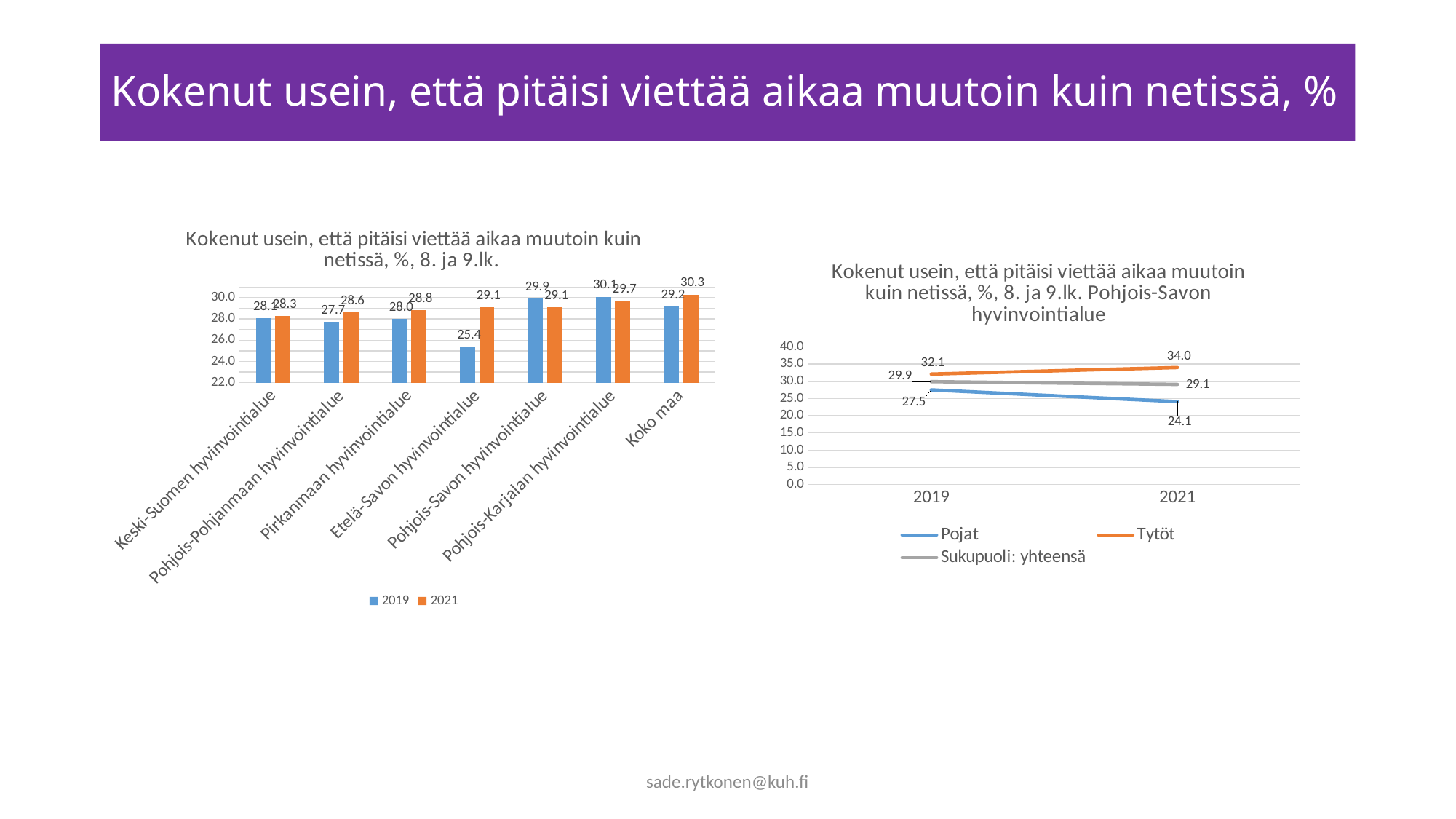
In the left bar chart, what is the 2021 value for Etelä-Savon hyvinvointialue? 29.1 In the right line chart (Pohjois-Savon hyvinvointialue), what is the difference between Tytöt and Pojat in 2021? 9.9 How many series does the legend of the left chart list? 2 In the right line chart (Pohjois-Savon hyvinvointialue), what is the value for Pojat in 2021? 24.1 In the right line chart (Pohjois-Savon hyvinvointialue), does the value for Pojat rise or fall from 2019 to 2021? Fall How many categories are shown on the x axis of the left bar chart? 7 In the left bar chart, for Pohjois-Savon hyvinvointialue, which year has the larger value, 2019 or 2021? 2019 In the left bar chart, which category has the highest 2021 value? Koko maa In the left bar chart, what is the 2019 value for Pohjois-Karjalan hyvinvointialue? 30.1 In the left bar chart, by how much did the value for Etelä-Savon hyvinvointialue increase from 2019 to 2021? 3.7 What kind of chart is the chart on the left of the slide? Bar chart In the left bar chart, which category has the lowest 2019 value? Etelä-Savon hyvinvointialue